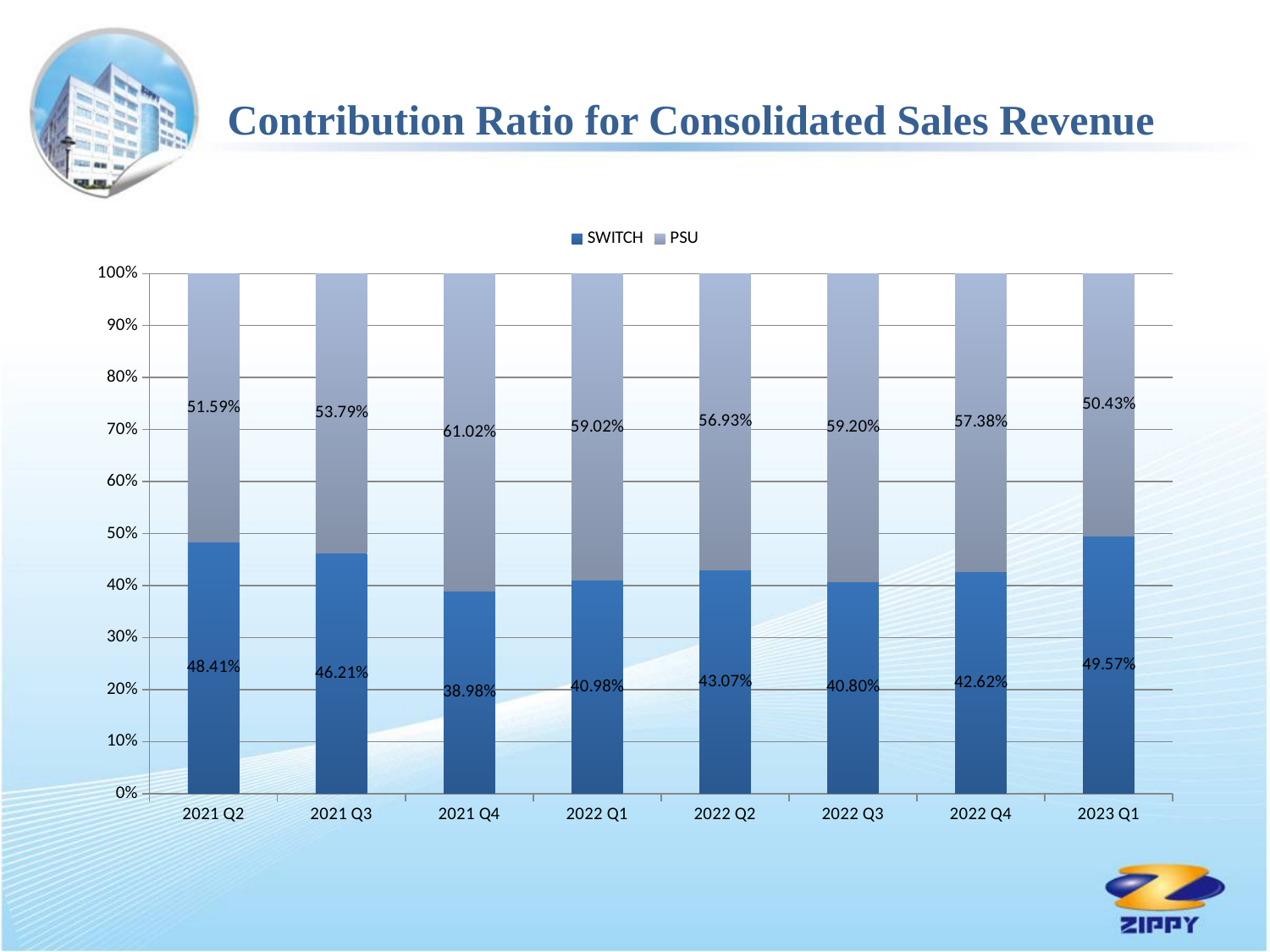
What kind of chart is shown on the slide? Stacked bar chart What is the SWITCH contribution ratio for 2021 Q4? 38.98% Is the SWITCH contribution ratio for 2022 Q2 greater or less than 40%? greater Which is larger in 2021 Q2, the SWITCH ratio or the PSU ratio? PSU How many series does the legend list? 2 What is the PSU contribution ratio for 2022 Q3? 59.20% Which quarter has the highest PSU contribution ratio? 2021 Q4 What is the difference between the PSU and SWITCH contribution ratios in 2022 Q1? 18.04% Which quarter has the lowest SWITCH contribution ratio? 2021 Q4 What is the SWITCH contribution ratio for 2023 Q1? 49.57% How many quarters are shown on the x axis? 8 What is the total of the SWITCH and PSU ratios for 2022 Q4? 100.00%